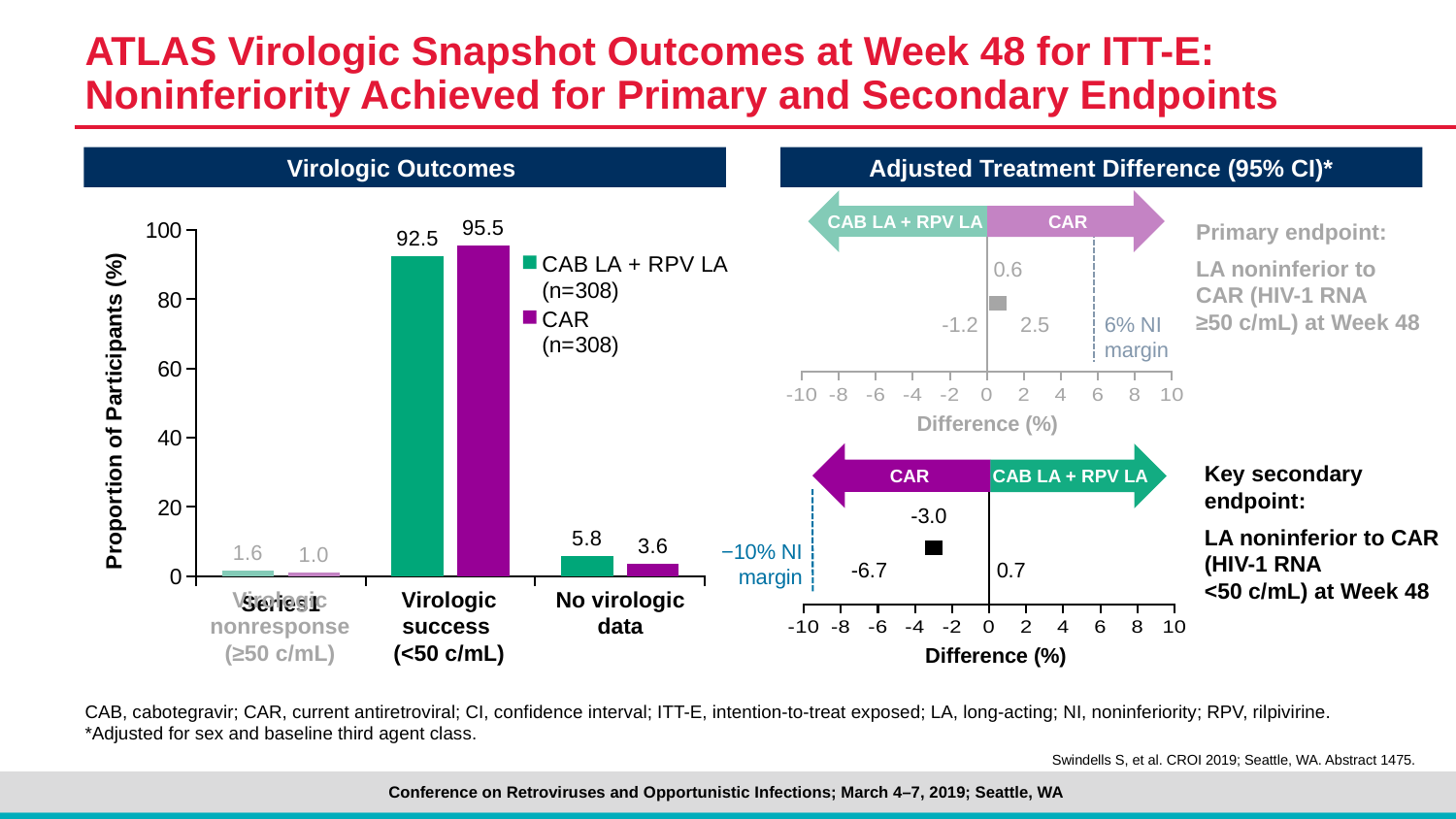
In the Virologic Outcomes chart, what is the value for CAR in the Virologic nonresponse (≥50 c/mL) category? 1.0 In the Virologic Outcomes chart, which series has the larger value in the No virologic data category? CAB LA + RPV LA How many series does the legend of the Virologic Outcomes chart list? 2 What kind of chart is the Virologic Outcomes chart? Bar chart In the Adjusted Treatment Difference chart for the key secondary endpoint, what is the lower bound of the 95% CI? -6.7 In the Virologic Outcomes chart, what is the value for CAB LA + RPV LA in the Virologic success (<50 c/mL) category? 92.5 In the Virologic Outcomes chart, what is the difference between the CAR and CAB LA + RPV LA values for Virologic success (<50 c/mL)? 3.0 In the Adjusted Treatment Difference chart for the primary endpoint, what is the point estimate of the difference? 0.6 In the Virologic Outcomes chart, what is the value for CAB LA + RPV LA in the No virologic data category? 5.8 In the Virologic Outcomes chart, which category has the highest value for CAB LA + RPV LA? Virologic success (<50 c/mL) In the Virologic Outcomes chart, what is the value for CAR in the No virologic data category? 3.6 In the Virologic Outcomes chart, what is the value for CAR in the Virologic success (<50 c/mL) category? 95.5